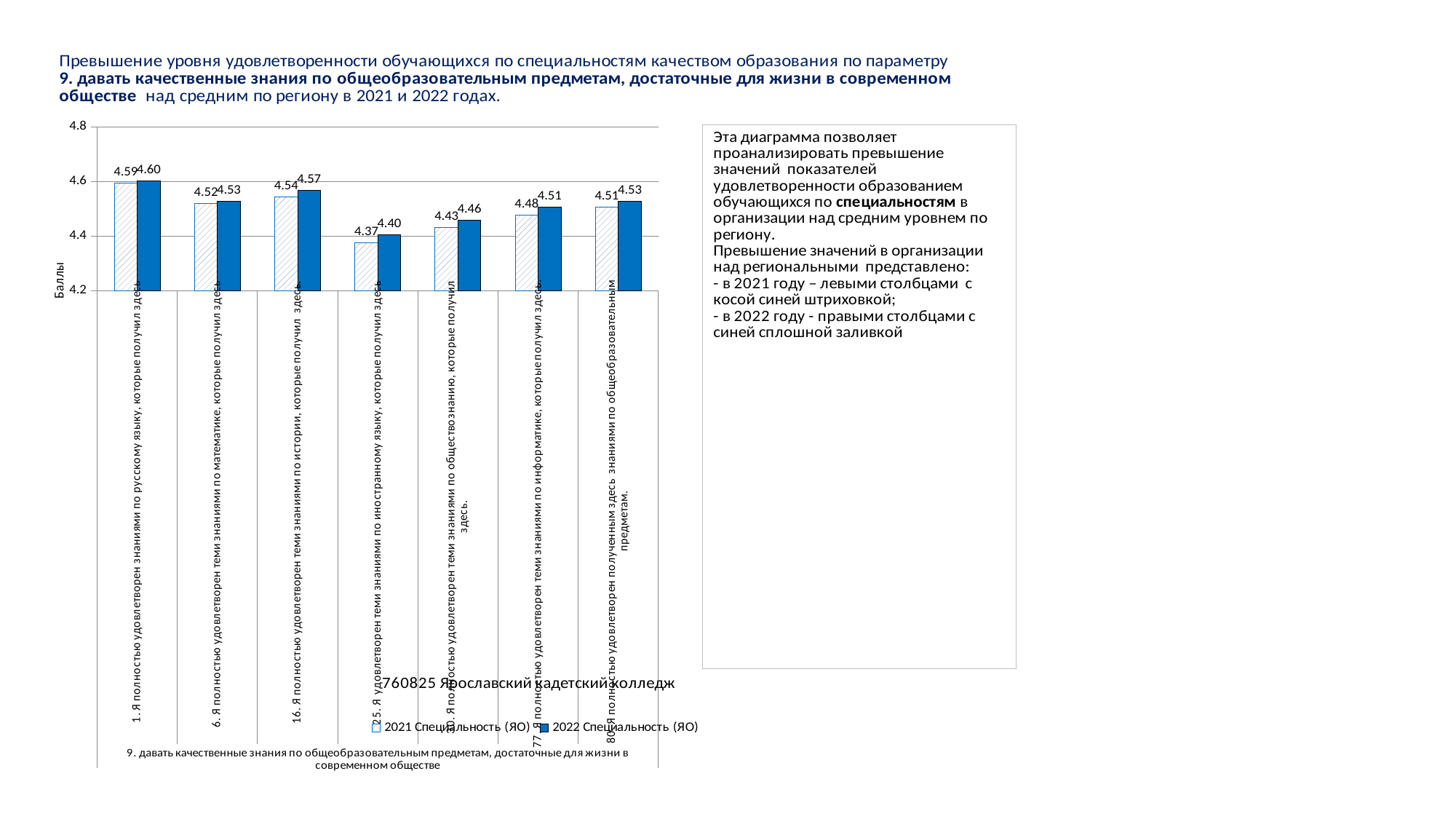
What is the difference between the 2022 and 2021 Специальность (ЯО) values for the category about knowledge in social studies (50. ...по обществознанию...)? 0.03 Which category has the highest 2022 Специальность (ЯО) value? 1. Я полностью удовлетворен знаниями по русскому языку, которые получил здесь What is the 2021 Специальность (ЯО) value for the category about knowledge in foreign language (25. Я удовлетворен теми знаниями по иностранному языку...)? 4.37 How many categories are shown on the x axis of the chart? 7 Which category has the lowest 2021 Специальность (ЯО) value? 25. Я удовлетворен теми знаниями по иностранному языку, которые получил здесь What is the 2021 Специальность (ЯО) value for the category about knowledge in history (16. ...по истории...)? 4.54 What is the label of the vertical axis of the chart? Баллы What kind of chart is shown on the slide? Bar chart What is the 2022 Специальность (ЯО) value for the category about knowledge in Russian language (1. Я полностью удовлетворен знаниями по русскому языку...)? 4.60 What is the 2022 Специальность (ЯО) value for the category about knowledge in informatics (77. ...по информатике...)? 4.51 How many series does the chart legend list? 2 Which is larger: the 2021 value for the mathematics category (6.) or the 2021 value for the history category (16.)? 16. (history), 4.54